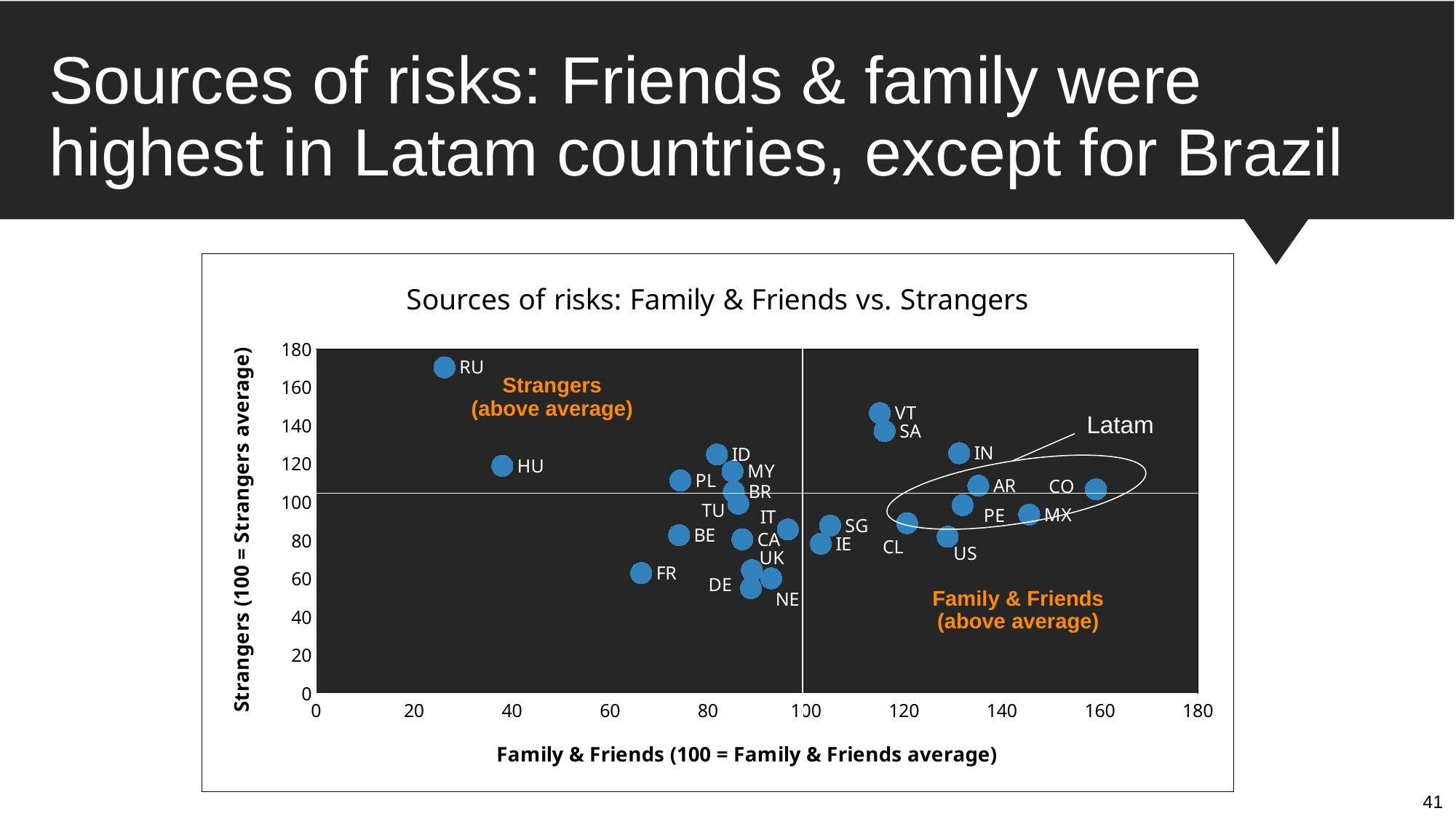
Which country has the lowest Family & Friends value in the chart? RU What kind of chart is shown on the slide? Scatter chart Which has the larger Strangers value, RU or HU? RU Is the Strangers value for RU greater or less than 160? greater Which country has the highest Strangers value in the chart? RU What is the title of the chart? Sources of risks: Family & Friends vs. Strangers Which country has the highest Family & Friends value in the chart? CO Is the Strangers value for FR greater or less than 80? less Is the Family & Friends value for CO greater or less than 140? greater What is the label of the vertical axis of the chart? Strangers (100 = Strangers average) How many country points are plotted in the chart? 25